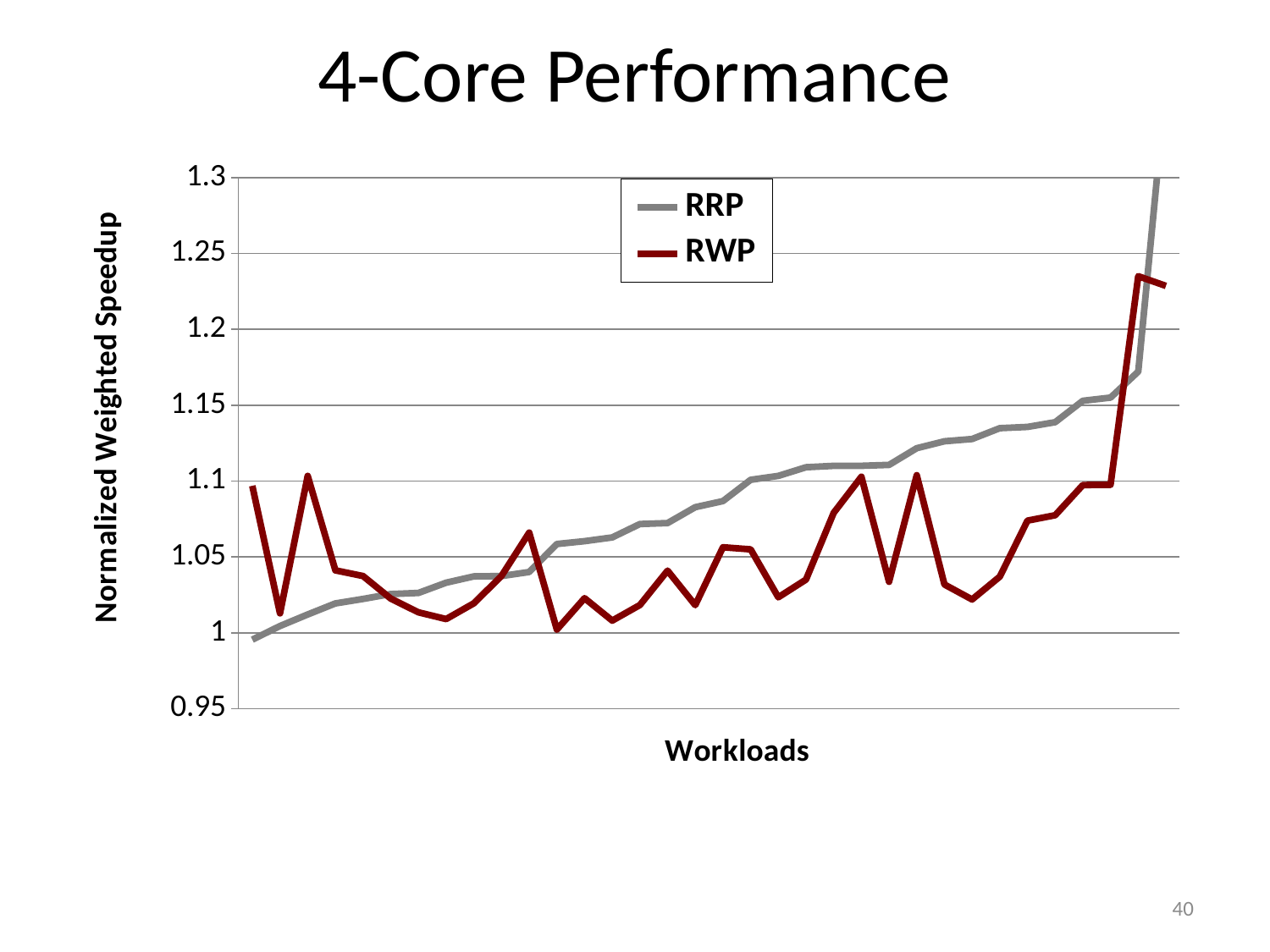
What are the two series named in the legend? RRP and RWP How many series does the legend list? 2 Is the highest value of the RWP line greater or less than 1.2? greater What is the title of the chart? 4-Core Performance At the leftmost workload, which series has the higher value, RRP or RWP? RWP What kind of chart is shown on the slide? line chart At the rightmost workload, which series has the higher value, RRP or RWP? RRP Which series reaches the highest value on the chart? RRP Is the lowest value of the RWP line greater or less than 1.05? less Is the highest value of the RRP line greater or less than 1.25? greater Does the RRP line rise or fall as you move from left to right along the x axis? rise